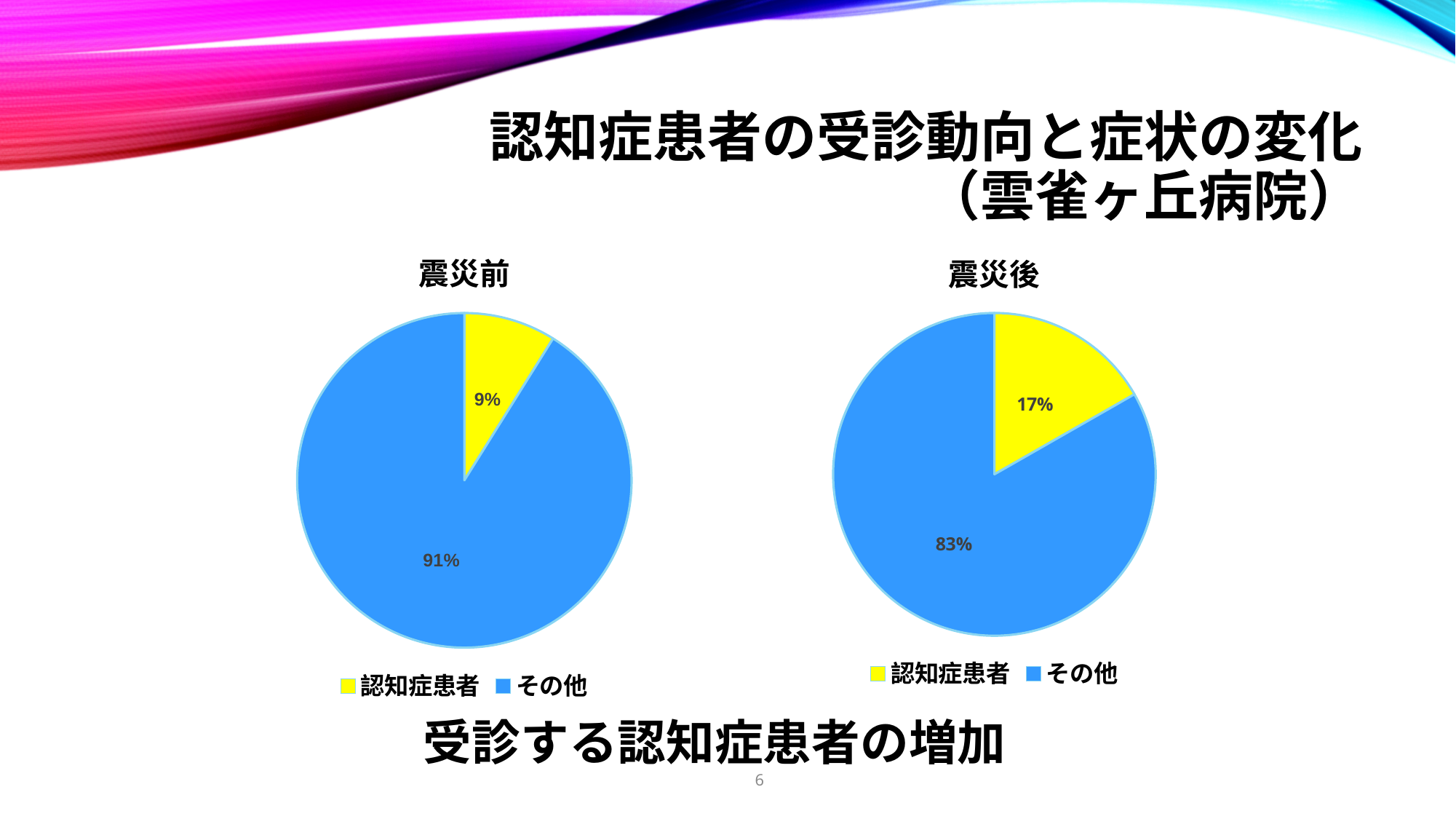
In the 震災後 chart, what colour is the 認知症患者 slice? Yellow How many slices does the 震災後 chart have? 2 What type of chart is the 震災前 chart? Pie chart How many entries does the legend of the 震災前 chart list? 2 In the 震災後 chart, which slice is the smallest? 認知症患者 In the 震災前 chart, what share of the pie is その他? 91% In the 震災前 chart, which slice is the largest? その他 In the 震災後 chart, what share of the pie is その他? 83% In the 震災前 chart, what share of the pie is 認知症患者? 9% What is the difference between the 認知症患者 share in the 震災後 chart and in the 震災前 chart? 8% Which chart has the larger 認知症患者 share, 震災前 or 震災後? 震災後